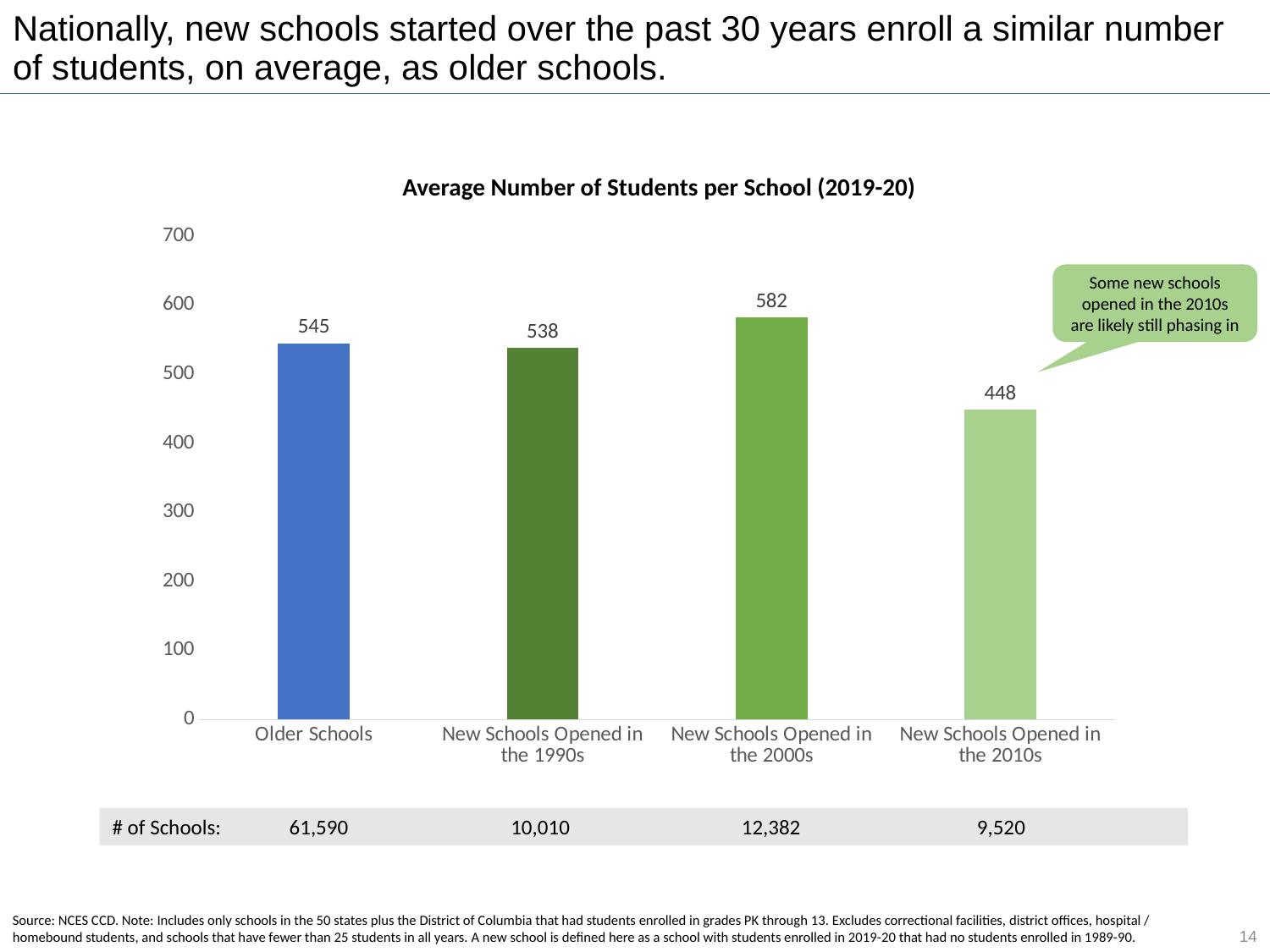
Which category has the lowest average number of students per school? New Schools Opened in the 2010s What kind of chart is shown on the slide? bar chart How many categories are shown on the x axis of the chart? 4 What is the difference in average students per school between New Schools Opened in the 2000s and New Schools Opened in the 2010s? 134 What is the average number of students per school for Older Schools? 545 What is the difference in average students per school between Older Schools and New Schools Opened in the 1990s? 7 Which has a larger average number of students per school: New Schools Opened in the 2000s or Older Schools? New Schools Opened in the 2000s What is the average number of students per school for New Schools Opened in the 1990s? 538 Is the value for New Schools Opened in the 2010s greater or less than 500? less What is the title of the chart? Average Number of Students per School (2019-20) What is the average number of students per school for New Schools Opened in the 2010s? 448 Which category has the highest average number of students per school? New Schools Opened in the 2000s